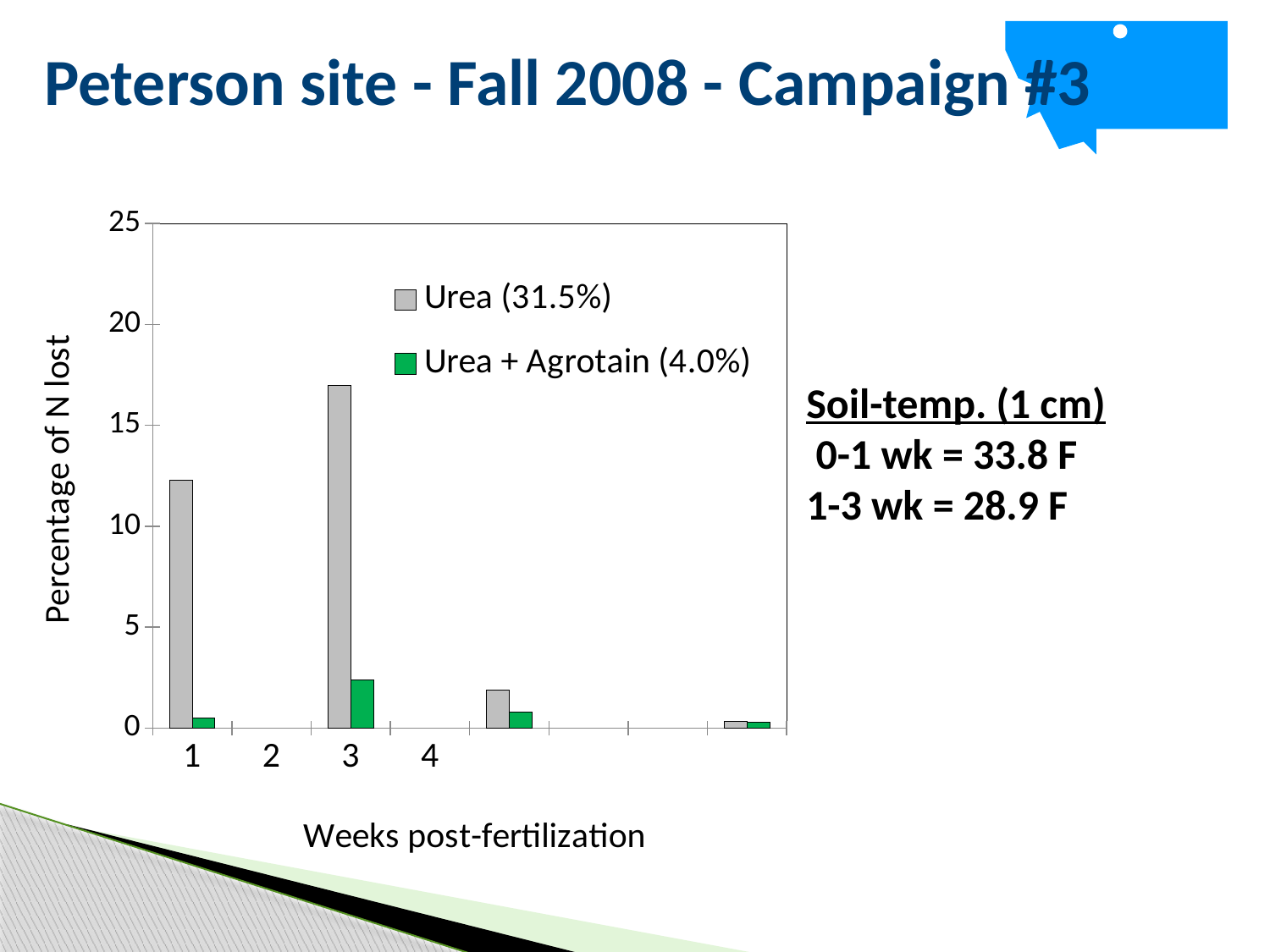
At week 1, which series has the larger value: Urea (31.5%) or Urea + Agrotain (4.0%)? Urea (31.5%) What are the two series named in the chart legend? Urea (31.5%) and Urea + Agrotain (4.0%) What is the highest value shown on the vertical axis of the chart? 25 Is the Urea + Agrotain (4.0%) value at week 3 greater or less than 5? less Is the Urea (31.5%) value at week 3 greater or less than 15? greater Is the Urea (31.5%) value at week 1 greater or less than 10? greater At week 3, which series has the smaller value: Urea (31.5%) or Urea + Agrotain (4.0%)? Urea + Agrotain (4.0%) What is the title of the vertical axis of the chart? Percentage of N lost Which is larger for Urea (31.5%): the value at week 1 or the value at week 3? Week 3 What kind of chart is shown on the slide? Bar chart How many series does the chart legend list? 2